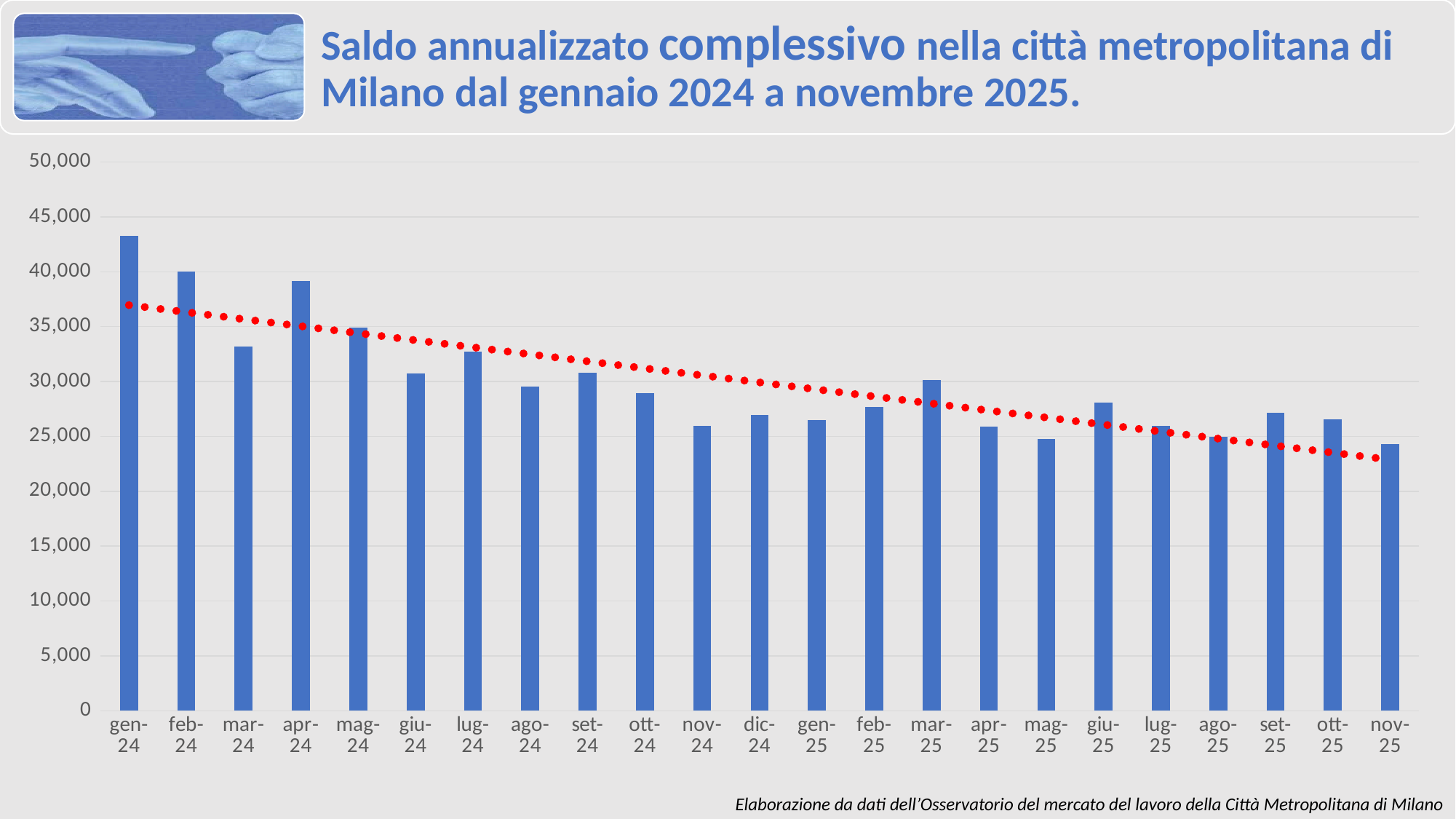
What is the title of the slide? Saldo annualizzato complessivo nella città metropolitana di Milano dal gennaio 2024 a novembre 2025. Which is larger, the value for mar-25 or the value for apr-25? mar-25 Is the value for mar-24 greater or less than 35,000? less Which is larger, the value for mar-24 or the value for apr-24? apr-24 Is the value for nov-25 greater or less than 25,000? less Is the value for gen-24 greater or less than 40,000? greater What kind of chart is shown on the slide? bar chart Overall, do the values rise or fall from gen-24 to nov-25? fall What does the red dotted line on the chart represent? a trend line How many monthly bars are plotted in the chart? 23 Which month has the highest value in the chart? gen-24